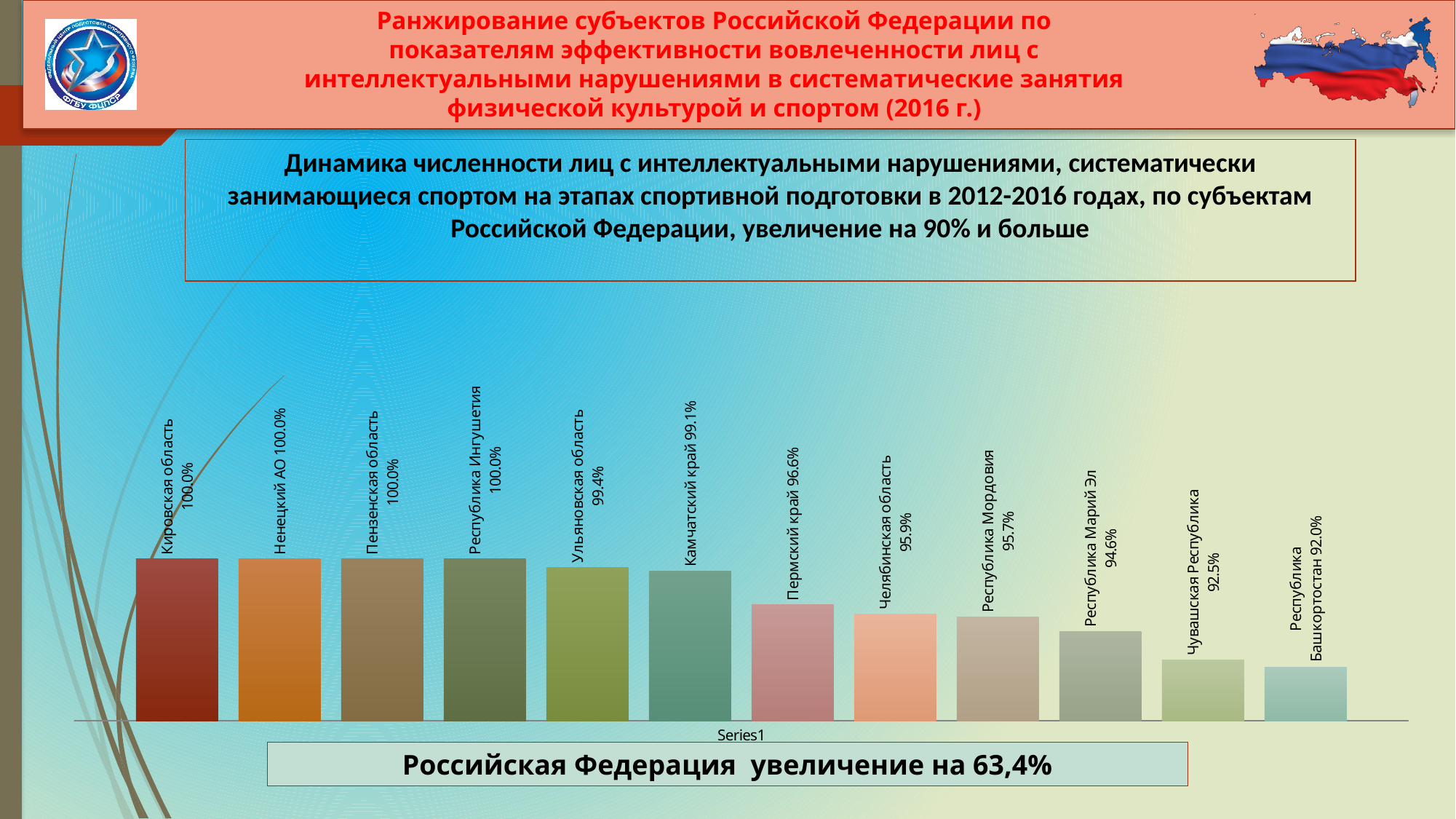
What is the value shown for Республика Марий Эл? 94.6% What is the value shown for Камчатский край? 99.1% What kind of chart is shown on the slide? Bar chart What is the difference between the values for Кировская область and Республика Башкортостан? 8.0% What is the value shown for Пермский край? 96.6% Which region has the lowest value in the chart? Республика Башкортостан Which is larger, the value for Республика Мордовия or the value for Чувашская Республика? Республика Мордовия What is the difference between the values for Пермский край and Челябинская область? 0.7% Do the values rise or fall from left to right across the chart? Fall What series name is shown below the bars on the x axis? Series1 What is the value shown for Ульяновская область? 99.4% How many regions (bars) are shown in the chart? 12